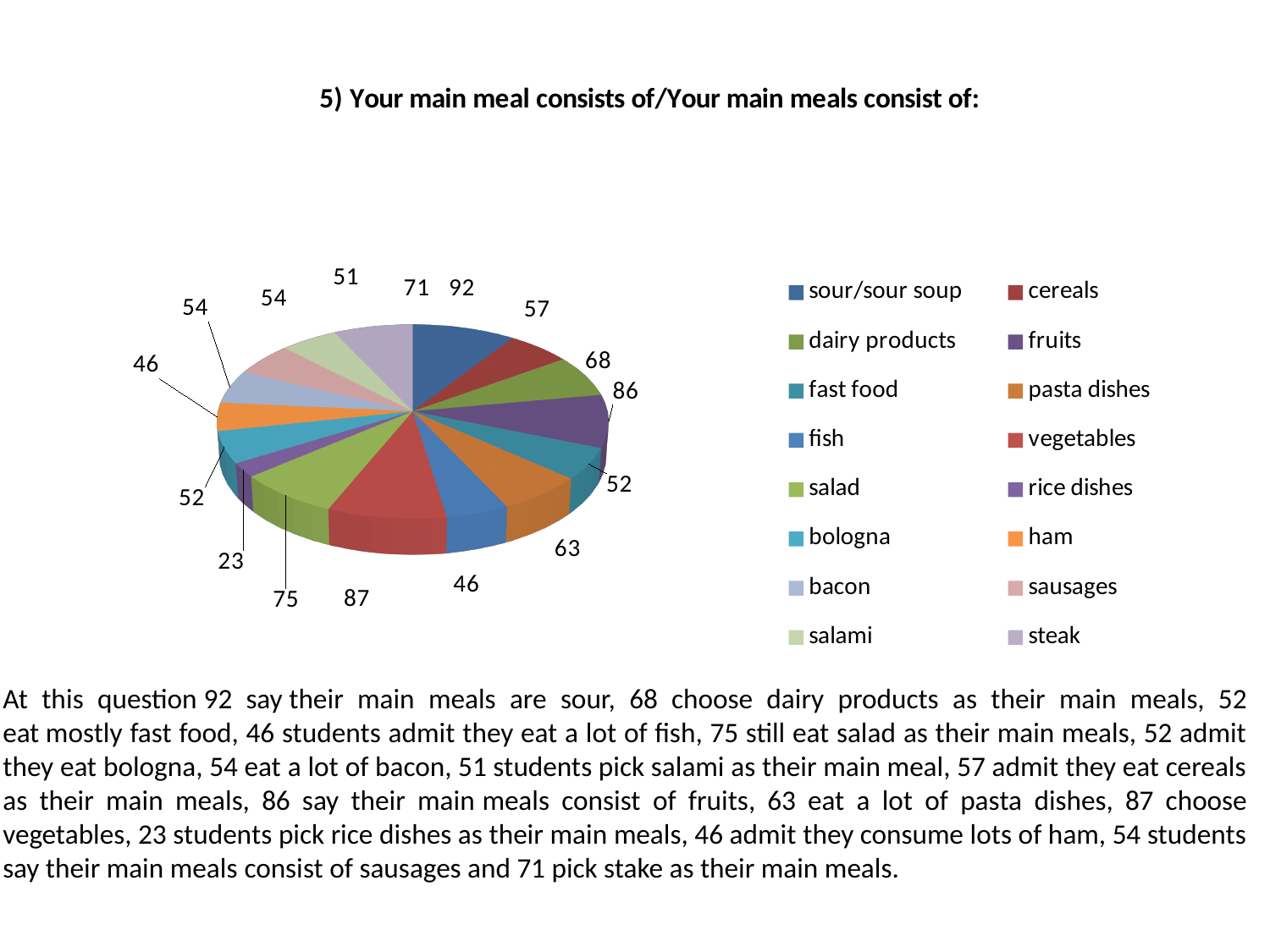
What is the value for sour/sour soup? 92 What is the difference between the values for vegetables and salad? 12 What is the title of the chart? 5) Your main meal consists of/Your main meals consist of: What kind of chart is shown on the slide? pie chart What is the value for steak? 71 How many categories does the pie chart show? 16 Which is larger, the value for fruits or the value for dairy products? fruits What is the value for rice dishes? 23 What is the value for vegetables? 87 Which category has the highest value? sour/sour soup Which category has the lowest value? rice dishes What is the difference between the values for sour/sour soup and rice dishes? 69